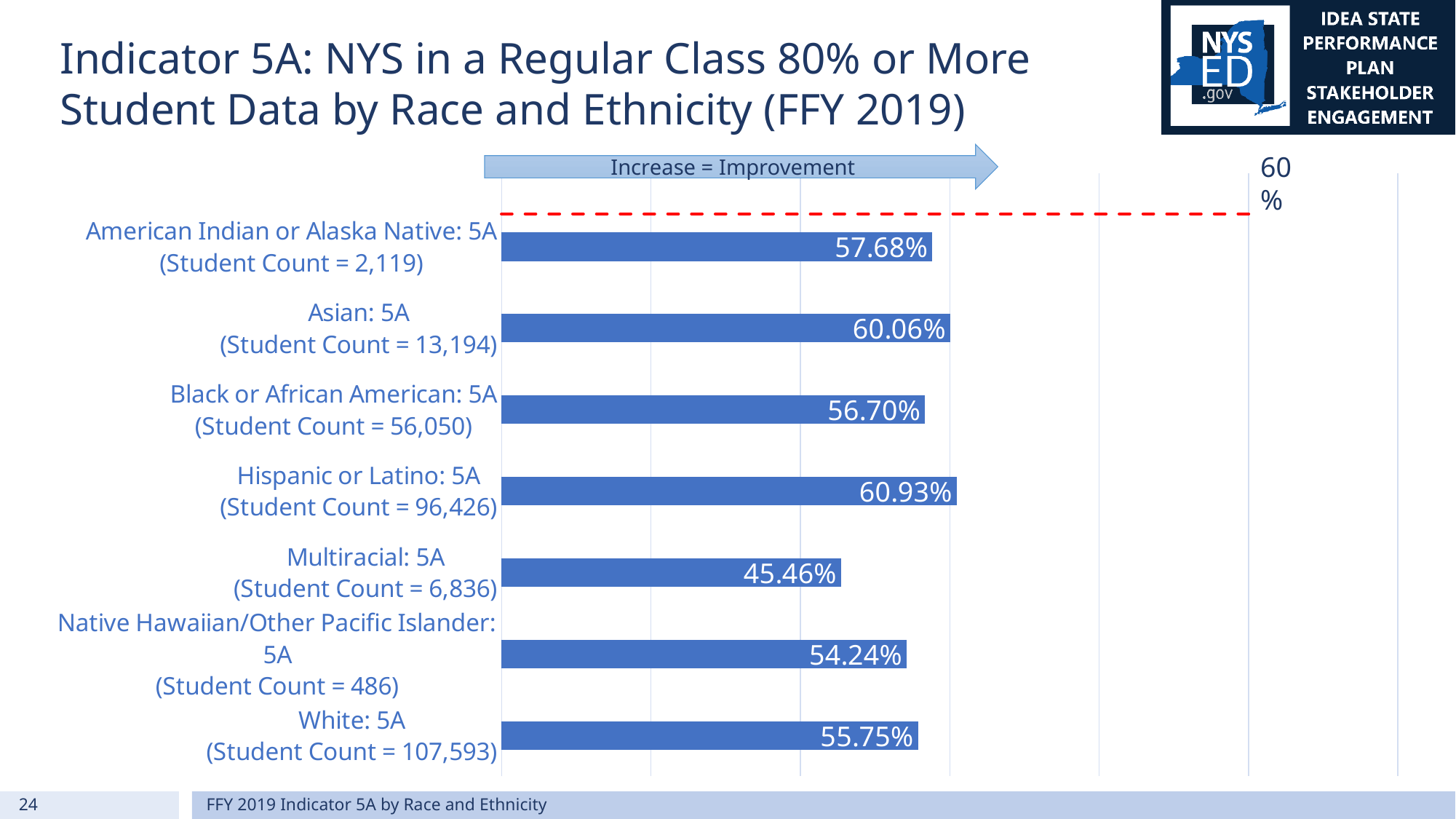
What target value is marked by the red dashed line? 60% Which is larger, the value for Black or African American: 5A or the value for American Indian or Alaska Native: 5A? American Indian or Alaska Native: 5A Which category has the highest value? Hispanic or Latino: 5A What is the value for Hispanic or Latino: 5A? 60.93% What is the value for Native Hawaiian/Other Pacific Islander: 5A? 54.24% What is the difference between the values for Hispanic or Latino: 5A and Multiracial: 5A? 15.47 percentage points What kind of chart is shown on the slide? Bar chart Which category has the lowest value? Multiracial: 5A What is the value for Multiracial: 5A? 45.46% What is the value for White: 5A? 55.75% What is the difference between the values for Asian: 5A and White: 5A? 4.31 percentage points How many categories are shown in the chart? 7